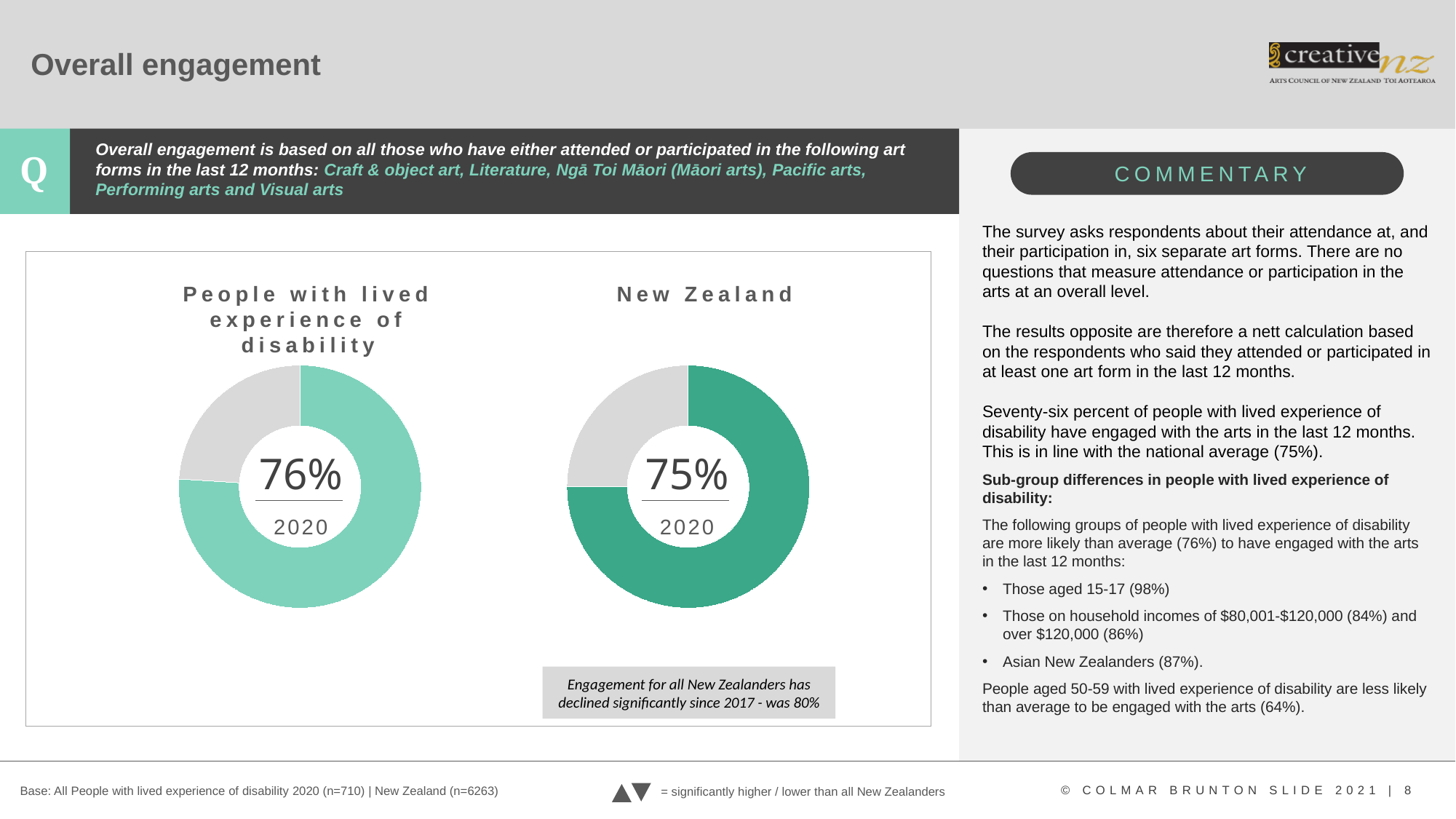
Has engagement for all New Zealanders risen or declined since 2017 according to the chart note? declined In the 'New Zealand' chart, is the engagement value greater or less than 50%? greater How many donut charts are shown on the slide? 2 In the 'People with lived experience of disability' chart, what share of the donut is not coloured (the grey remainder)? 24% According to the note under the 'New Zealand' chart, what was engagement for all New Zealanders in 2017? 80% What year is labelled beneath the percentage in the 'New Zealand' donut chart? 2020 What type of chart is used to show overall engagement for people with lived experience of disability? Donut (pie) chart What is the title of the left-hand donut chart? People with lived experience of disability What is the difference between the engagement value for people with lived experience of disability and the value for New Zealand? 1 percentage point In the 'New Zealand' chart, what percentage is shown in the centre of the donut? 75% Which chart shows the higher engagement value, 'People with lived experience of disability' or 'New Zealand'? People with lived experience of disability In the 'People with lived experience of disability' chart, what percentage is shown in the centre of the donut? 76%